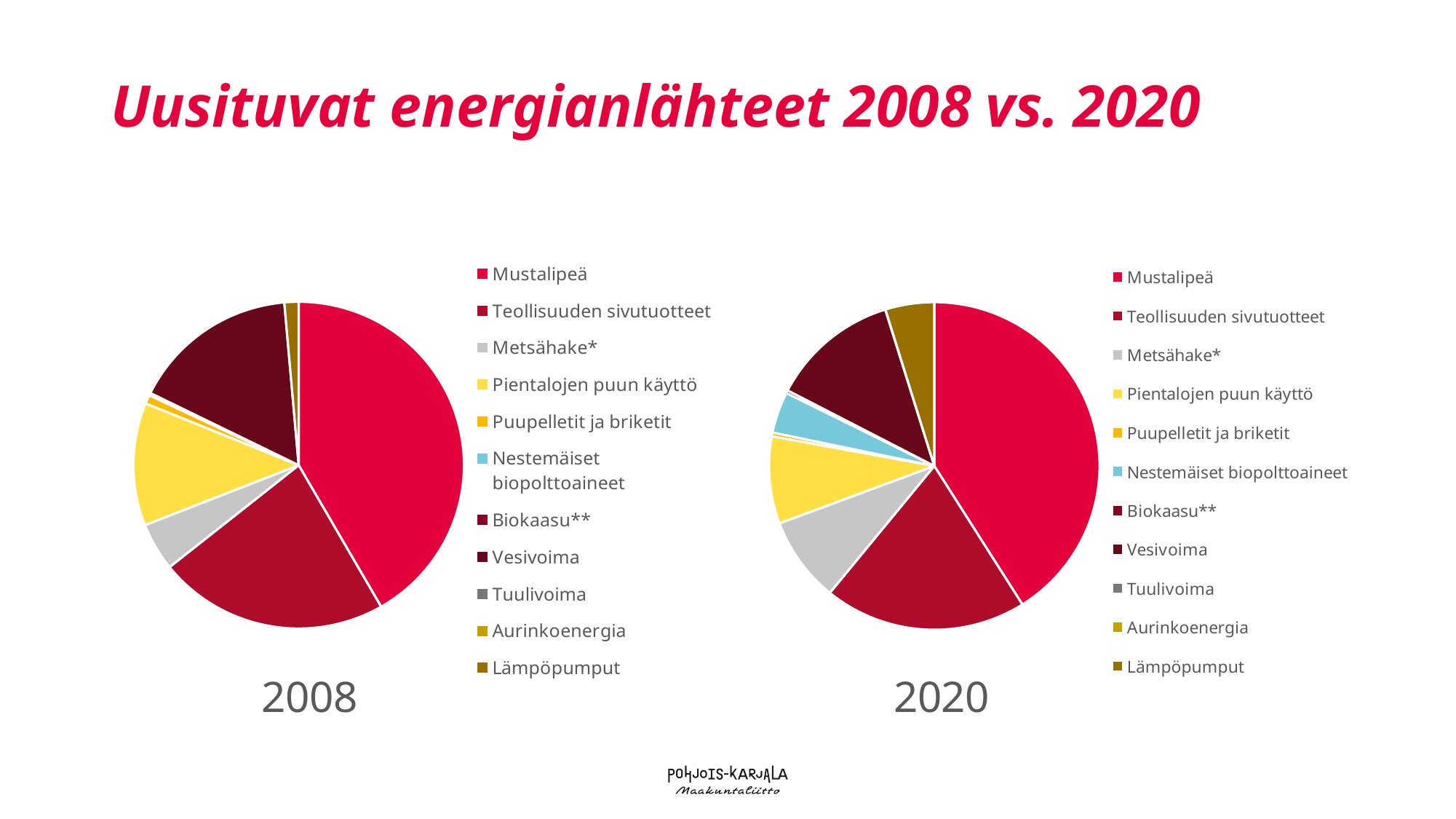
What kind of chart is used for the 2020 data on the right? pie chart In the 2008 pie chart, which slice is larger: Pientalojen puun käyttö or Metsähake*? Pientalojen puun käyttö How many entries does the legend of the 2020 pie chart list? 11 In the 2008 pie chart, which slice is larger: Teollisuuden sivutuotteet or Vesivoima? Teollisuuden sivutuotteet In the 2020 pie chart, which slice is larger: Vesivoima or Lämpöpumput? Vesivoima What is the title of the slide containing the two pie charts? Uusituvat energianlähteet 2008 vs. 2020 In the 2020 pie chart, which category has the largest slice? Mustalipeä In the 2008 pie chart, which category has the largest slice? Mustalipeä In the 2020 pie chart, what colour is the Nestemäiset biopolttoaineet slice? light blue How many entries does the legend of the 2008 pie chart list? 11 What kind of chart is used for the 2008 data on the left? pie chart